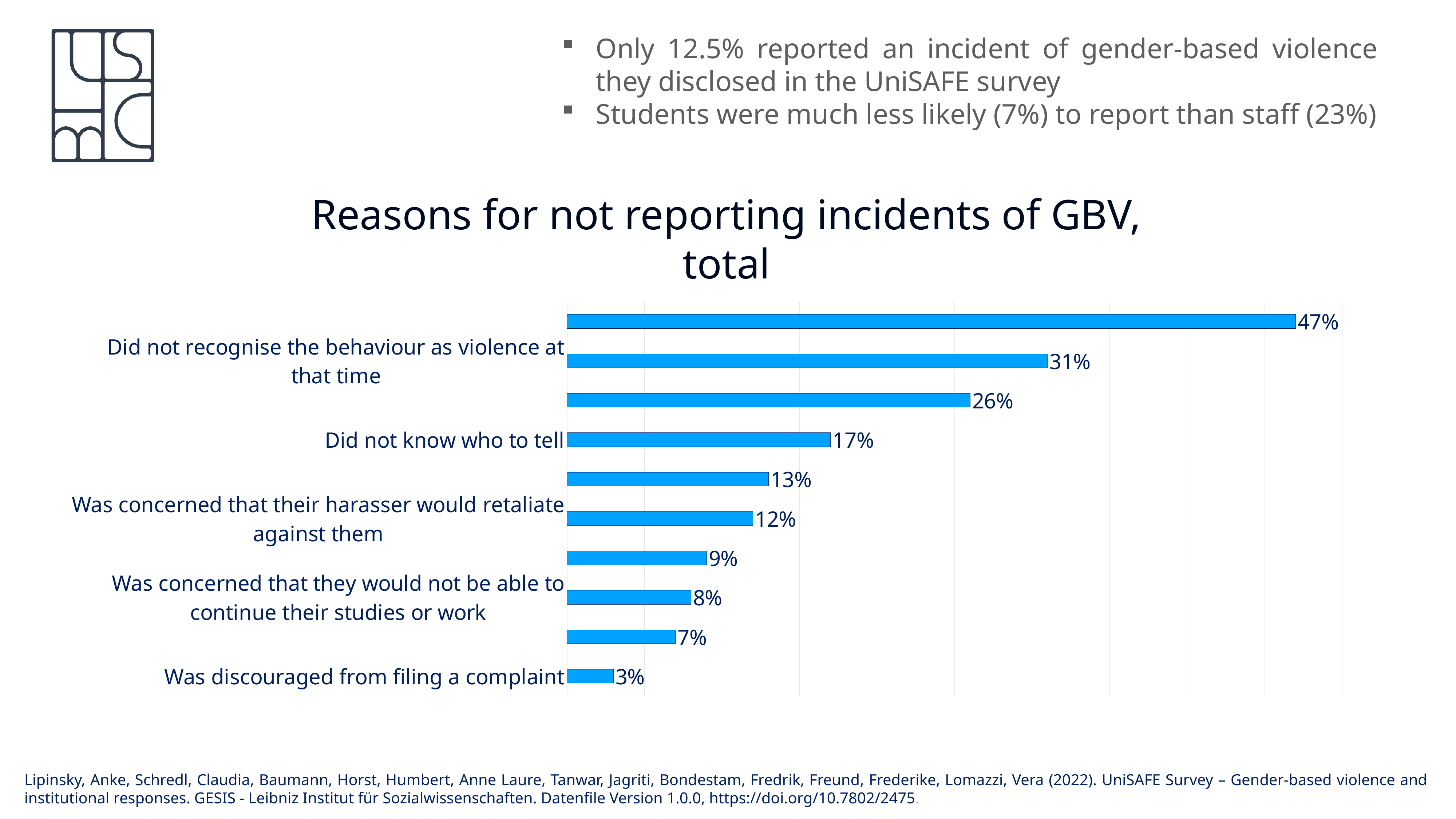
What is the title of the chart? Reasons for not reporting incidents of GBV, total What is the largest value shown on the chart? 47% How many bars are plotted on the chart? 10 What is the difference between the values for "Did not recognise the behaviour as violence at that time" and "Did not know who to tell"? 14 percentage points Which is larger: the value for "Was concerned that their harasser would retaliate against them" or "Was concerned that they would not be able to continue their studies or work"? Was concerned that their harasser would retaliate against them What is the value for "Did not know who to tell"? 17% Which labelled category has the lowest value? Was discouraged from filing a complaint What kind of chart is shown on the slide? bar chart What is the value for "Did not recognise the behaviour as violence at that time"? 31% What is the value for "Was concerned that their harasser would retaliate against them"? 12% What is the value for "Was concerned that they would not be able to continue their studies or work"? 8% What is the value for "Was discouraged from filing a complaint"? 3%